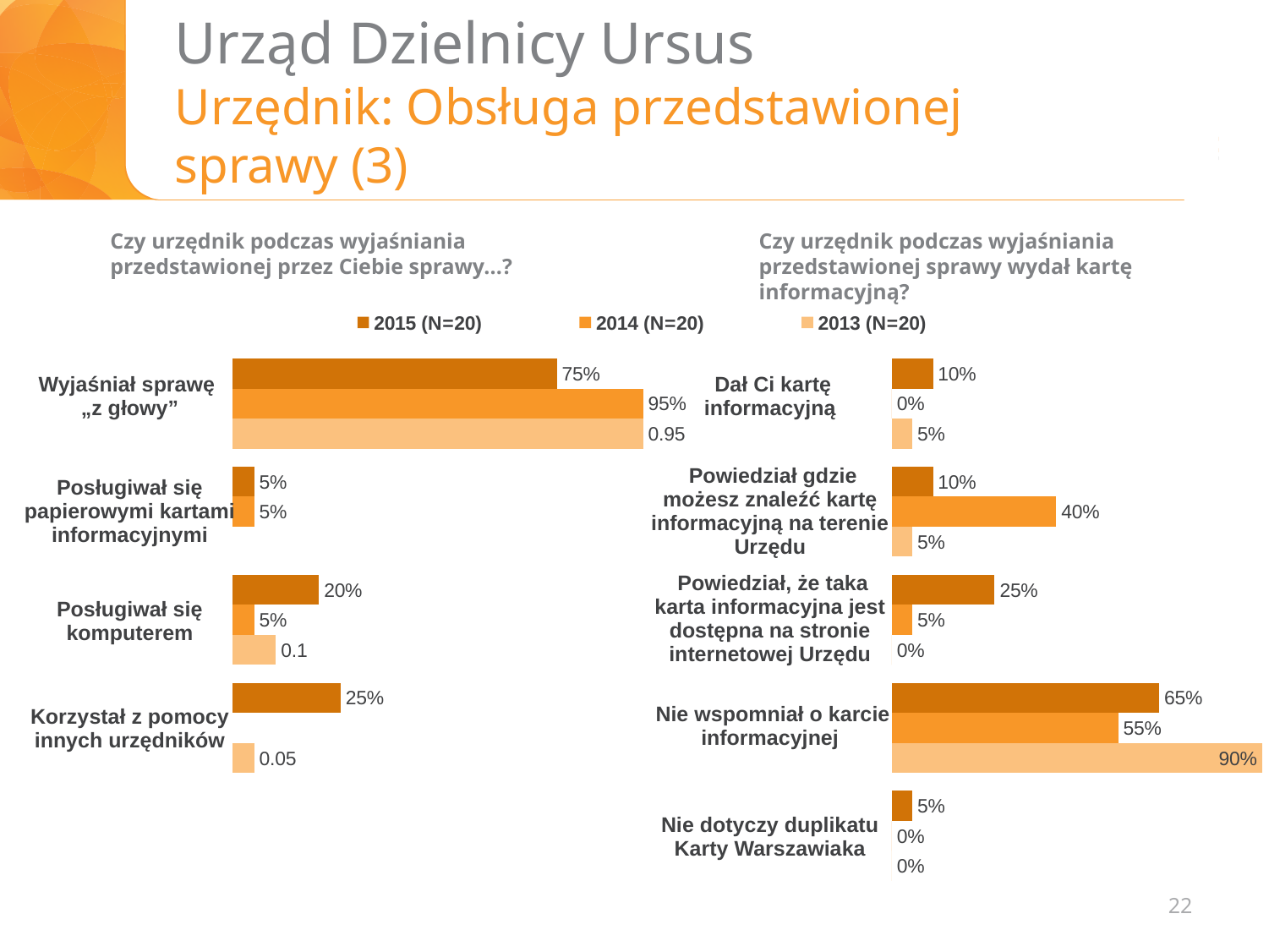
In the left chart, which category has the highest 2015 (N=20) value? Wyjaśniał sprawę „z głowy” In the right chart, which is larger for "Nie wspomniał o karcie informacyjnej": the 2015 value or the 2014 value? 2015 In the left chart ("Czy urzędnik podczas wyjaśniania przedstawionej przez Ciebie sprawy...?"), what is the 2015 (N=20) value for "Wyjaśniał sprawę „z głowy”"? 75% In the right chart, what is the difference between the 2013 and 2015 values for "Nie wspomniał o karcie informacyjnej"? 25% In the right chart, what is the 2014 (N=20) value for "Powiedział gdzie możesz znaleźć kartę informacyjną na terenie Urzędu"? 40% In the right chart, which category has the highest 2015 (N=20) value? Nie wspomniał o karcie informacyjnej In the left chart, what is the 2014 (N=20) value for "Wyjaśniał sprawę „z głowy”"? 95% What type of chart is used on this slide? Bar chart In the left chart, what is the difference between the 2015 and 2014 values for "Posługiwał się komputerem"? 15% In the right chart ("Czy urzędnik podczas wyjaśniania przedstawionej sprawy wydał kartę informacyjną?"), what is the 2013 (N=20) value for "Nie wspomniał o karcie informacyjnej"? 90% How many series does the legend list? 3 In the left chart, what is the 2015 (N=20) value for "Korzystał z pomocy innych urzędników"? 25%